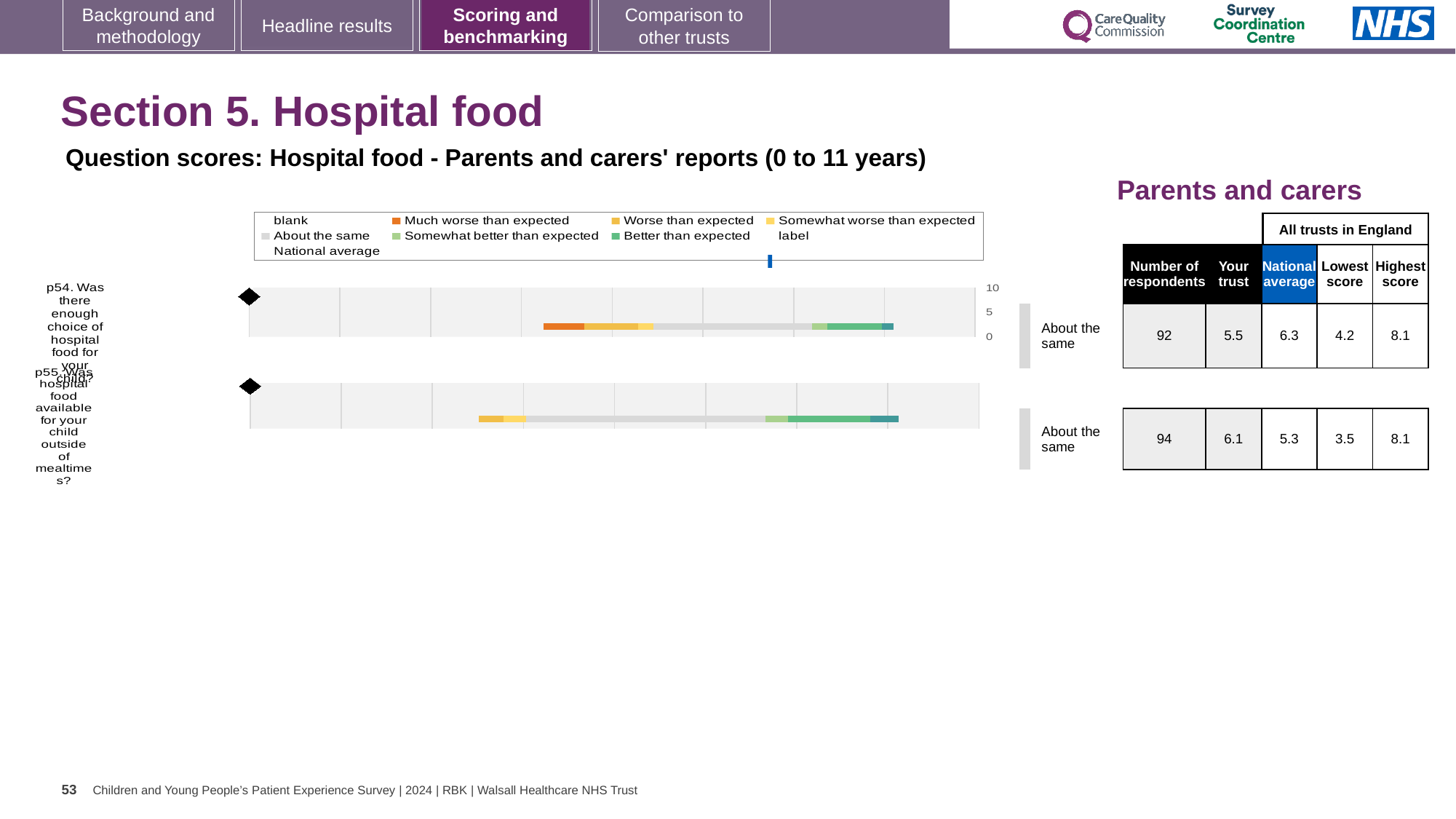
Which question has the higher 'Your trust' score, p54 or p55? p55 What is the national average score for p54? 6.3 For p54, which is larger: the trust's score or the national average? National average What is the lowest score across all trusts in England for p55? 3.5 What is the 'Your trust' score for p55 (hospital food available outside of mealtimes)? 6.1 What kind of chart is shown on the slide? bar chart How many questions (categories) are plotted in the chart? 2 How many respondents answered p55? 94 What benchmark category is shown for both p54 and p55? About the same Is the 'Your trust' score for p54 greater or less than 5? greater What is the 'Your trust' score for p54 (enough choice of hospital food)? 5.5 What is the difference between the highest and lowest score across all trusts for p54? 3.9